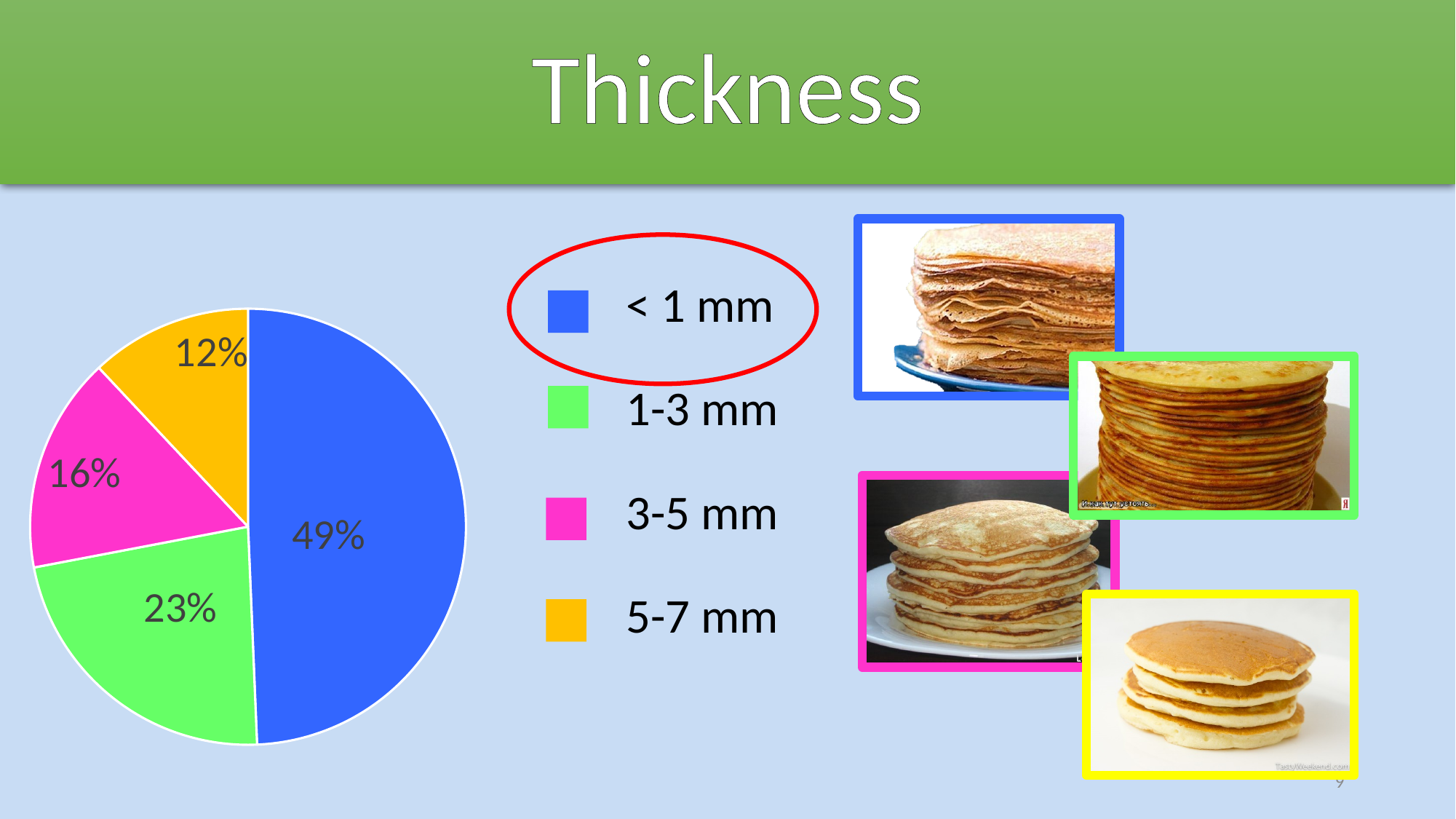
What share of the pie does the 1-3 mm category have? 23% Which legend entry is circled in red? < 1 mm What share of the pie does the 3-5 mm category have? 16% What is the difference in percentage points between the < 1 mm and 1-3 mm shares? 26 Which thickness category has the smallest share of the pie? 5-7 mm Which thickness category has the largest share of the pie? < 1 mm How many categories does the pie chart show? 4 What share of the pie does the 5-7 mm category have? 12% What share of the pie does the < 1 mm category have? 49% What is the title of the slide containing the chart? Thickness Which has a larger share, 3-5 mm or 5-7 mm? 3-5 mm What kind of chart is shown on the slide? pie chart